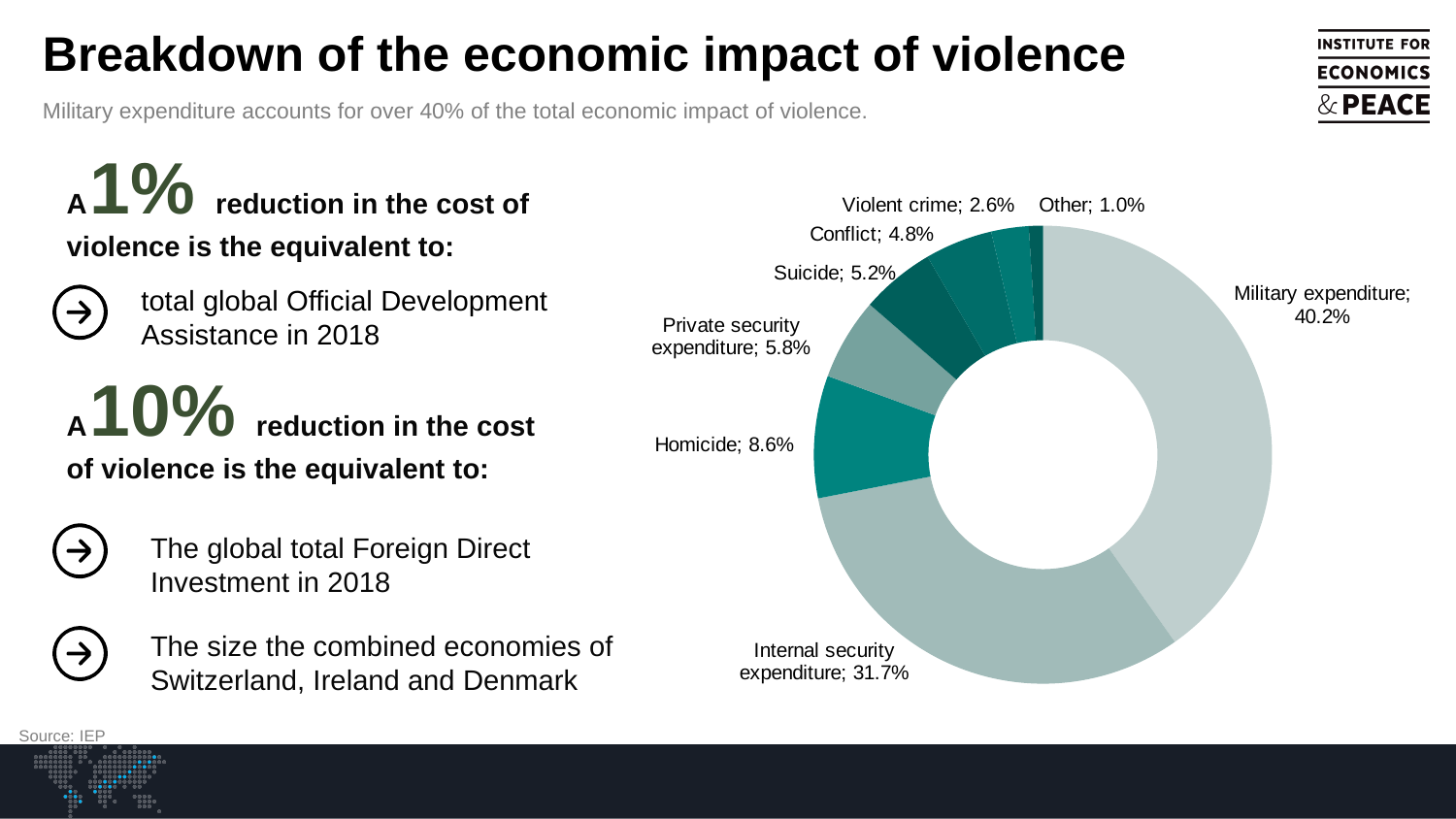
Which is larger, the share for Private security expenditure or the share for Conflict? Private security expenditure What is the difference between the shares for Military expenditure and Internal security expenditure? 8.5% How many categories are shown in the chart? 8 What is the combined share of Violent crime and Other? 3.6% What is the value shown for Internal security expenditure? 31.7% What is the value shown for Suicide? 5.2% What is the value shown for Homicide? 8.6% What kind of chart is shown on the slide? Pie chart (doughnut) What share of the economic impact of violence is attributed to Military expenditure? 40.2% Which category has the smallest share of the economic impact of violence? Other What is the title of the slide containing the chart? Breakdown of the economic impact of violence Which category has the largest share of the economic impact of violence? Military expenditure